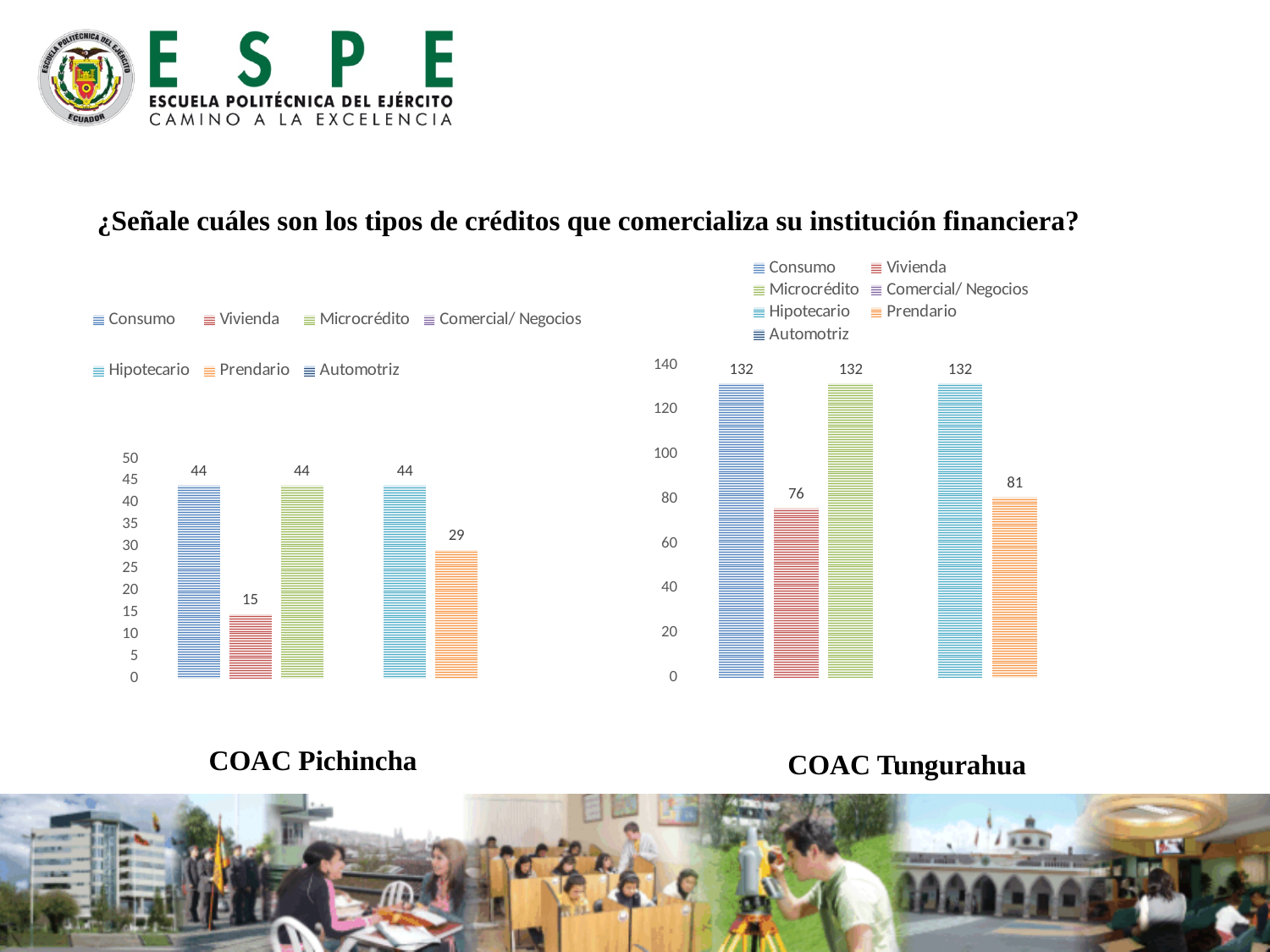
In the COAC Tungurahua chart, what is the value for Prendario? 81 How many series does the legend of the COAC Pichincha chart list? 7 In the COAC Pichincha chart, what is the value for Vivienda? 15 In the COAC Pichincha chart, what is the difference between the Consumo value and the Vivienda value? 29 In the COAC Tungurahua chart, what is the value for Vivienda? 76 In the COAC Tungurahua chart, what is the value for Consumo? 132 In the COAC Tungurahua chart, which is larger, Prendario or Vivienda? Prendario In the COAC Pichincha chart, which series has the lowest value? Vivienda In the COAC Tungurahua chart, which series has the lowest value? Vivienda What kind of chart is the COAC Tungurahua chart? Bar chart In the COAC Pichincha chart, what is the value for Prendario? 29 In the COAC Tungurahua chart, what is the difference between the Microcrédito value and the Prendario value? 51